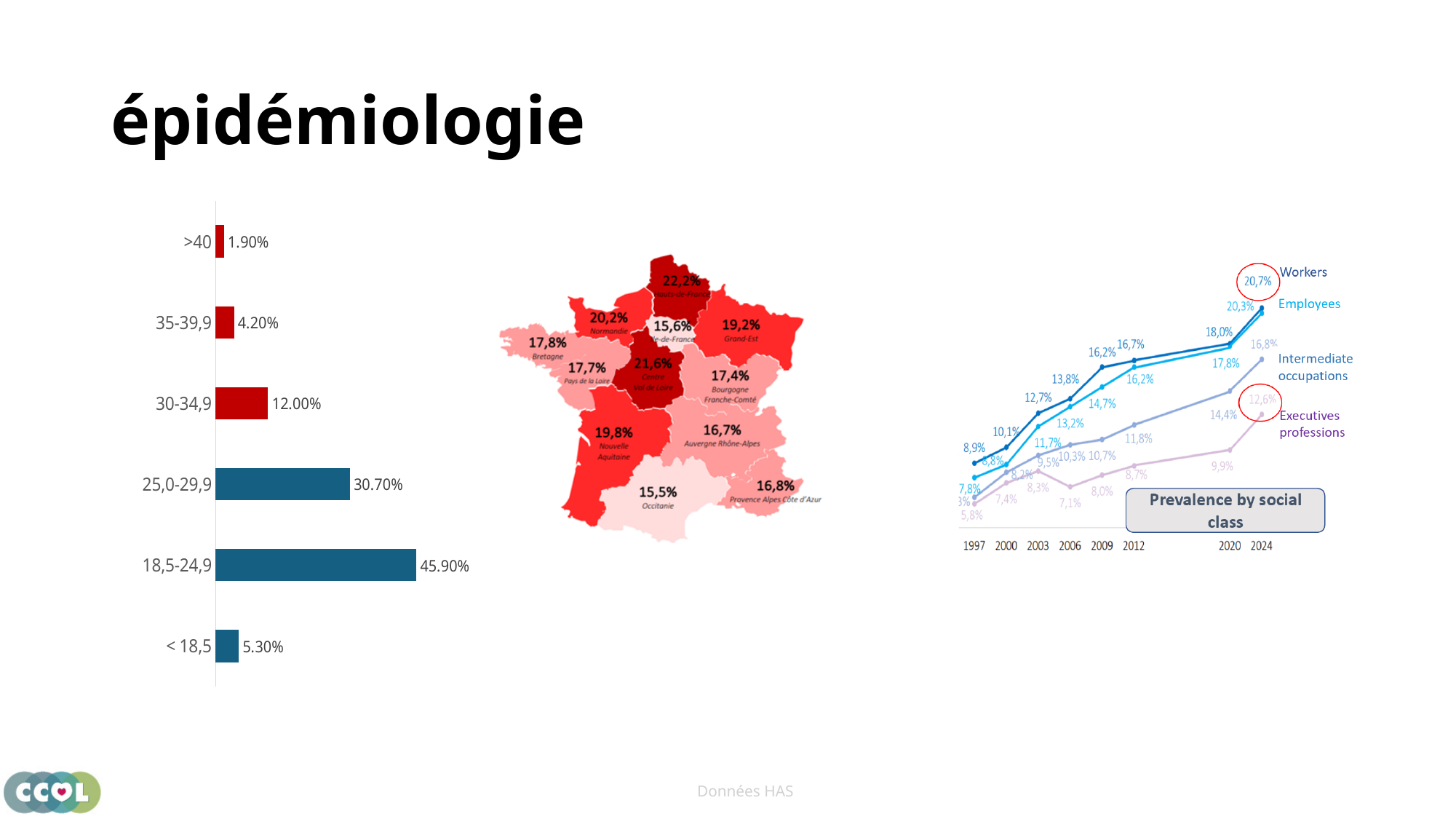
What kind of chart is the chart on the left of the slide? Bar chart In the 'Prevalence by social class' chart, do the values for Workers rise or fall from 1997 to 2024? Rise In the bar chart on the left, which category has the highest value? 18,5-24,9 How many series does the 'Prevalence by social class' chart show? 4 In the bar chart on the left, which category has the lowest value? >40 In the bar chart on the left, what is the value for the 30-34,9 category? 12.00% In the bar chart on the left, what is the value for the 18,5-24,9 category? 45.90% In the 'Prevalence by social class' chart, what is the value for Workers in 2024? 20,7% In the 'Prevalence by social class' chart, what is the value for Executives professions in 2024? 12,6% How many categories does the bar chart on the left show? 6 In the bar chart on the left, which is larger: the value for < 18,5 or the value for 35-39,9? < 18,5 In the bar chart on the left, what is the difference between the values for 25,0-29,9 and 30-34,9? 18.70%